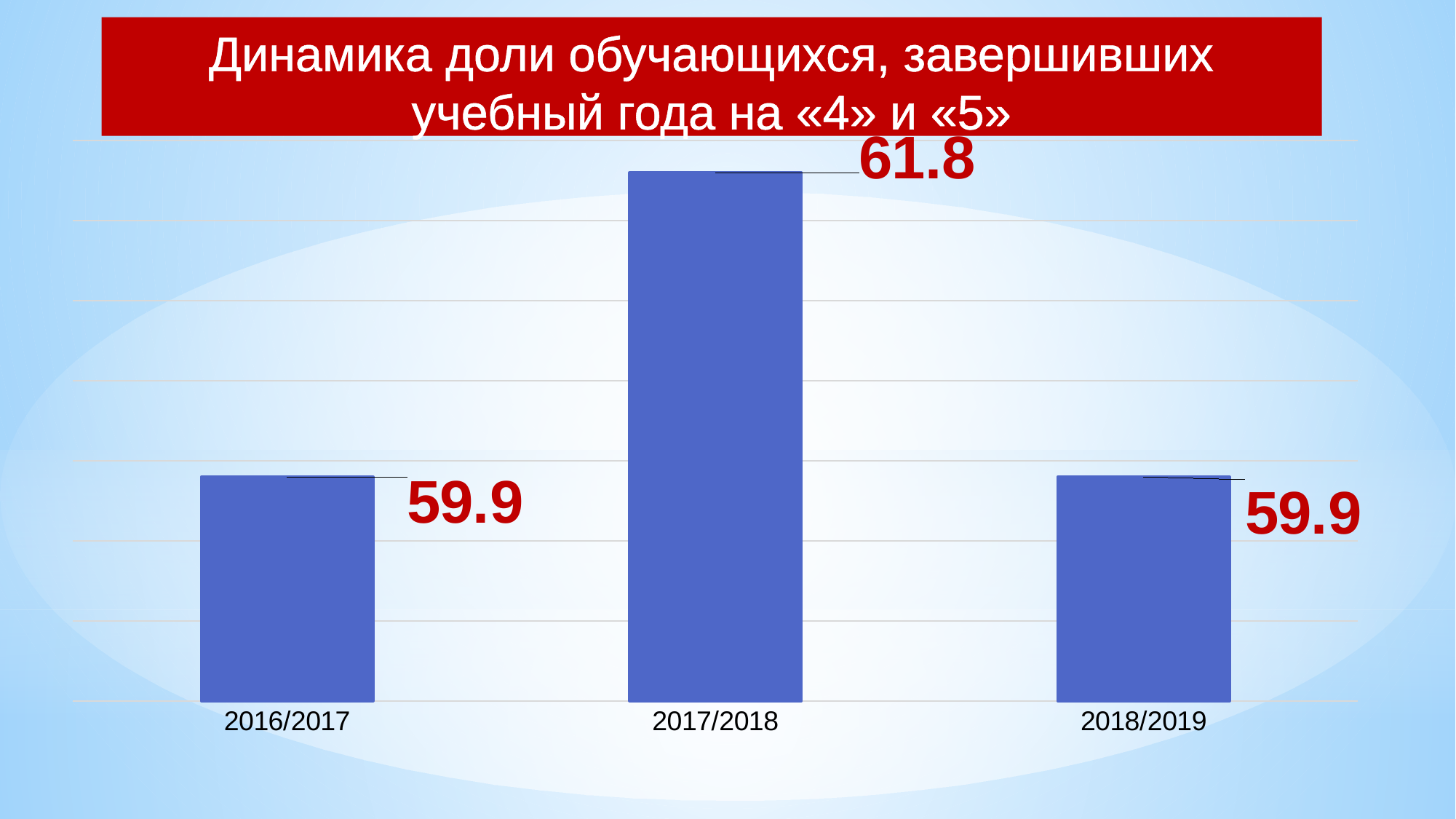
What colour are the bars on the chart? blue What is the difference between the values for 2017/2018 and 2016/2017? 1.9 Does the value rise or fall from 2017/2018 to 2018/2019? fall How many academic years are shown on the chart? 3 Does the value rise or fall from 2016/2017 to 2017/2018? rise What is the value for 2016/2017? 59.9 Are the values for 2016/2017 and 2018/2019 the same or different? the same Which is larger, the value for 2017/2018 or the value for 2018/2019? 2017/2018 What kind of chart is shown on the slide? bar chart What is the value for 2017/2018? 61.8 Which academic year has the highest value? 2017/2018 What is the value for 2018/2019? 59.9